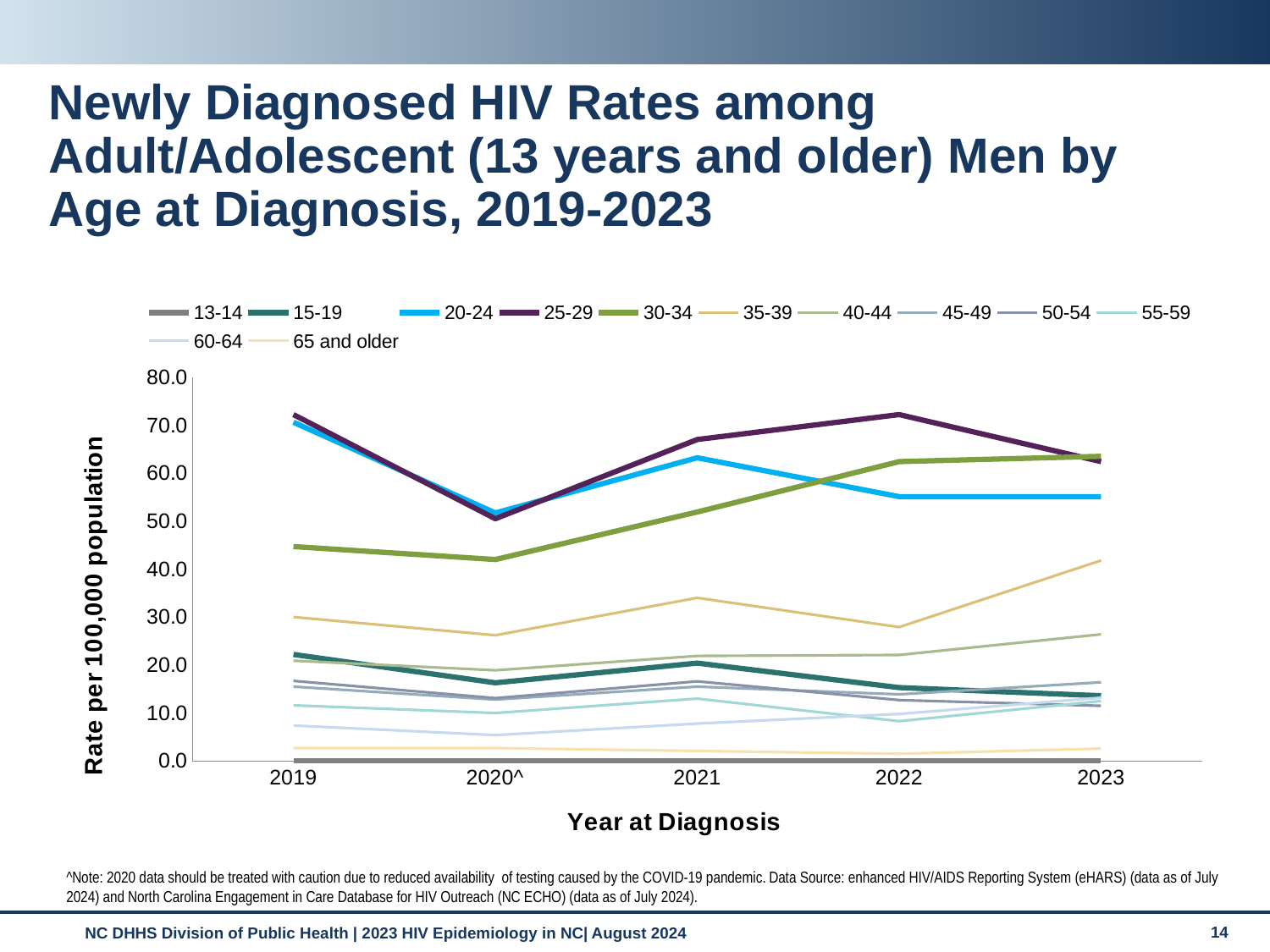
Is the rate for the 65 and older group in 2019 greater or less than 10? less How many age-group series does the legend list? 12 Which age group has the highest rate in 2022? 25-29 What is the label of the x axis? Year at Diagnosis What kind of chart is shown on the slide? line chart Is the rate for the 35-39 group in 2023 greater or less than 30? greater In 2019, which has the higher rate: the 20-24 group or the 30-34 group? 20-24 How many years are plotted along the x axis? 5 Does the rate for the 30-34 group rise or fall from 2020^ to 2022? rise What is the label of the y axis? Rate per 100,000 population Is the rate for the 30-34 group in 2020^ greater or less than 50? less Which age group has the lowest rate in 2019? 13-14